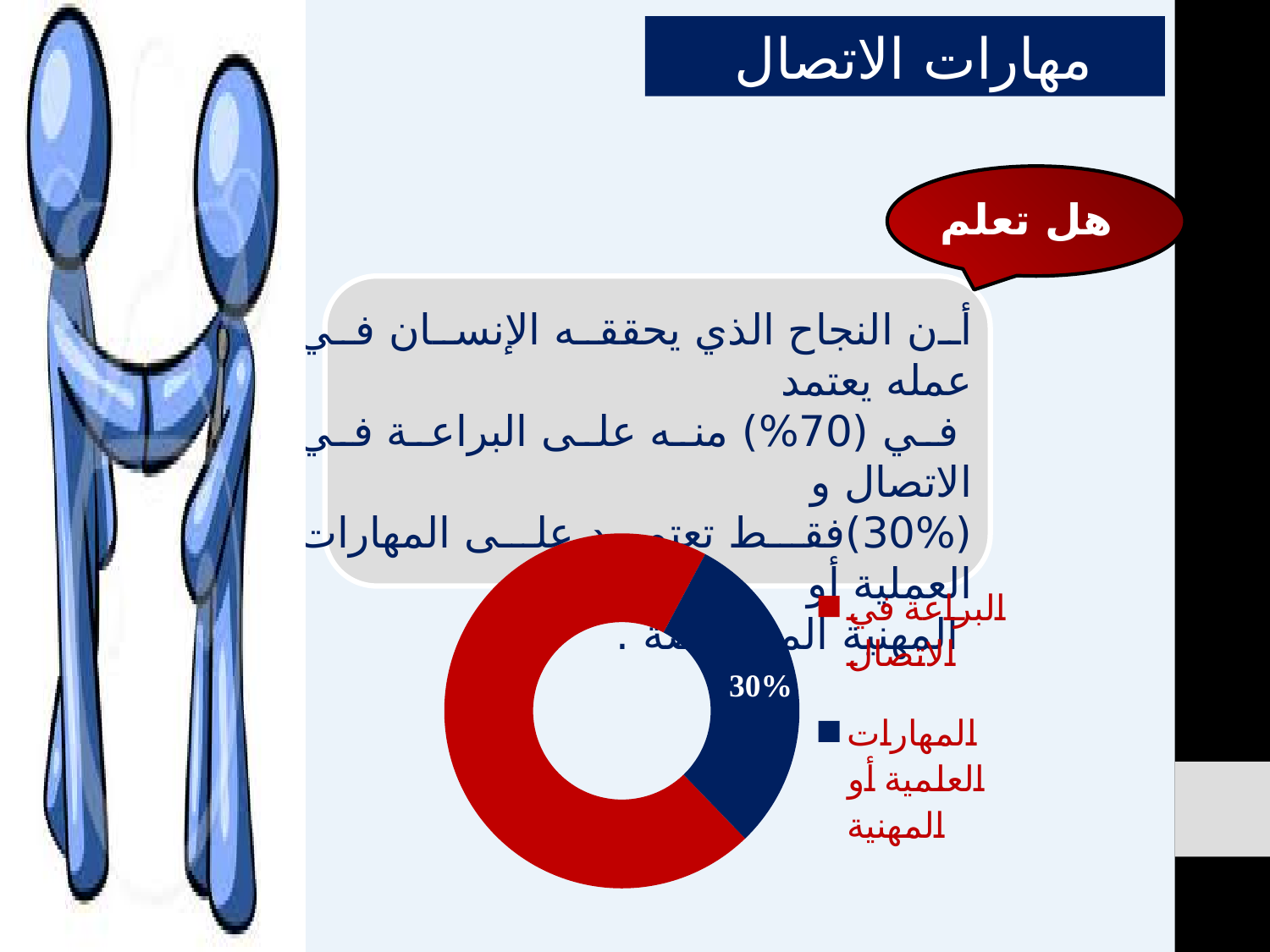
Is the share for المهارات العلمية أو المهنية greater or less than 50%? less What colour is the largest slice of the chart? red How many slices does the doughnut chart have? 2 Is the share for البراعة في الاتصال greater or less than 50%? greater What percentage is shown for المهارات العلمية أو المهنية in the chart? 30% How many entries does the chart legend list? 2 Which category has the smallest slice in the chart? المهارات العلمية أو المهنية What kind of chart is shown on the slide? doughnut chart Which category has the largest slice in the chart? البراعة في الاتصال Which slice is larger, البراعة في الاتصال or المهارات العلمية أو المهنية? البراعة في الاتصال What colour represents المهارات العلمية أو المهنية in the chart? blue